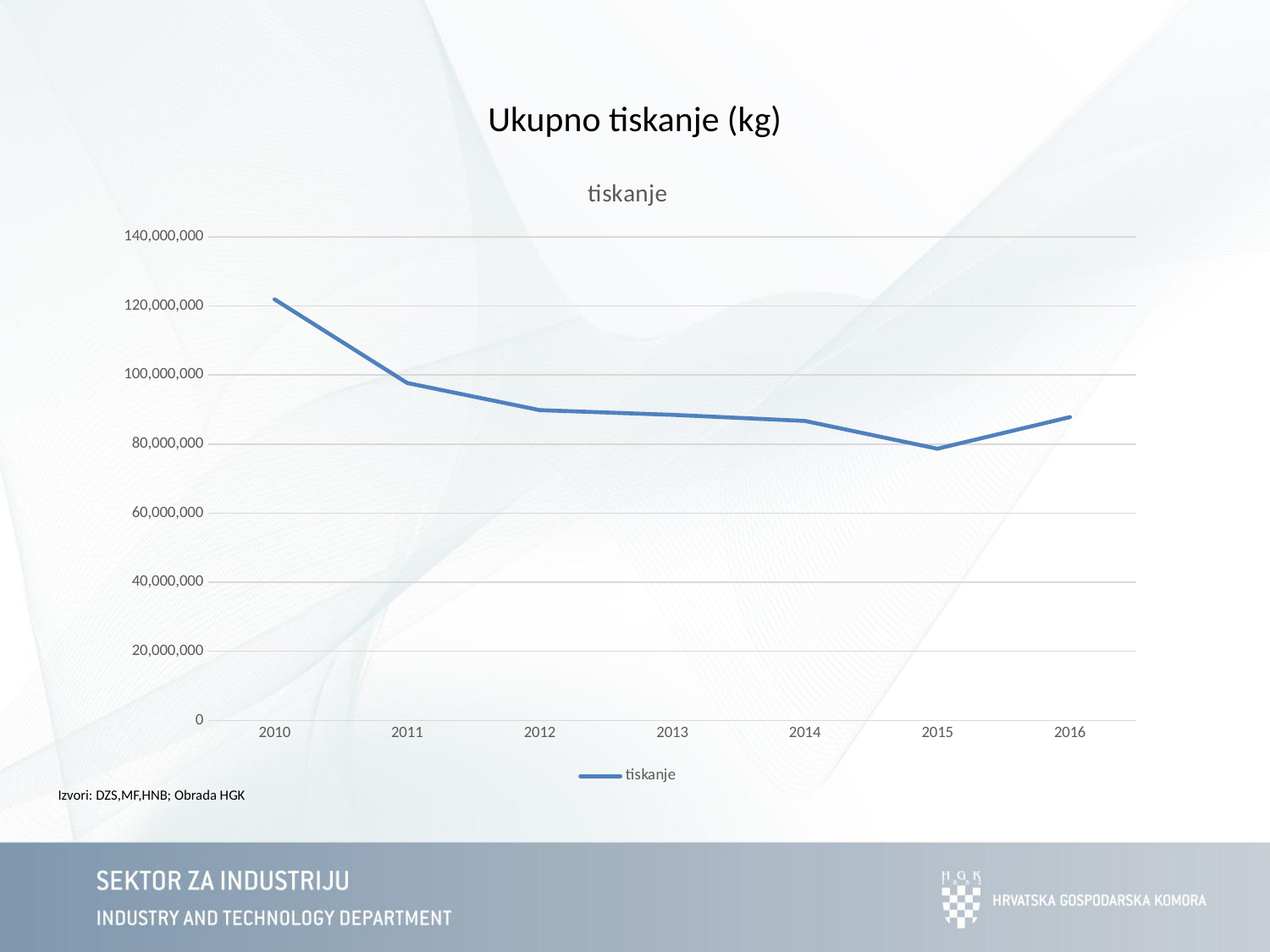
Is the value for tiskanje in 2011 greater or less than 100,000,000? less How many years are plotted on the x axis of the chart? 7 Which year has the lowest value for tiskanje? 2015 Which year has the highest value for tiskanje? 2010 Is the value for tiskanje in 2013 greater or less than 100,000,000? less Is the value for tiskanje in 2010 greater or less than 100,000,000? greater Which year has a larger value for tiskanje, 2015 or 2016? 2016 Does the value for tiskanje rise or fall from 2010 to 2015? fall How many series does the chart legend list? 1 What is the title shown above the chart on the slide? Ukupno tiskanje (kg) What kind of chart is shown on the slide? line chart